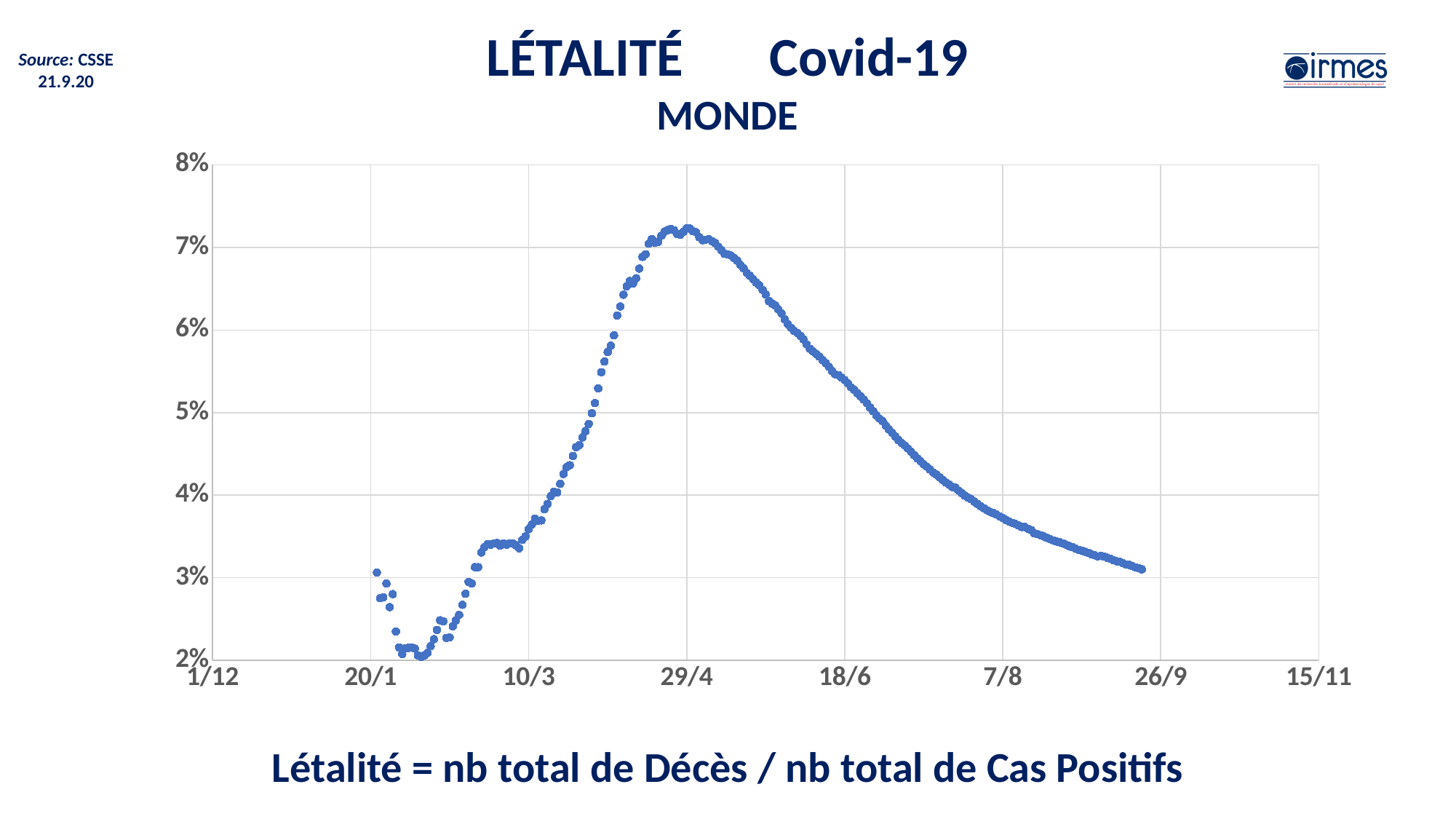
What kind of chart is shown on the slide? Scatter chart Around which x-axis date does the lethality reach its highest value? 29/4 What is the highest value shown on the y axis? 8% Is the value at 10/3 greater or less than 4%? less Do the values rise or fall between 29/4 and 26/9? fall Which is larger, the value at 18/6 or the value at 7/8? 18/6 Is the value at 18/6 greater or less than 6%? less What is the title of the chart? LÉTALITÉ Covid-19 MONDE Is the lowest plotted value closer to 20/1 or to 10/3 on the x axis? 20/1 Do the values rise or fall between 10/3 and 29/4? rise Is the value at 7/8 greater or less than 4%? less